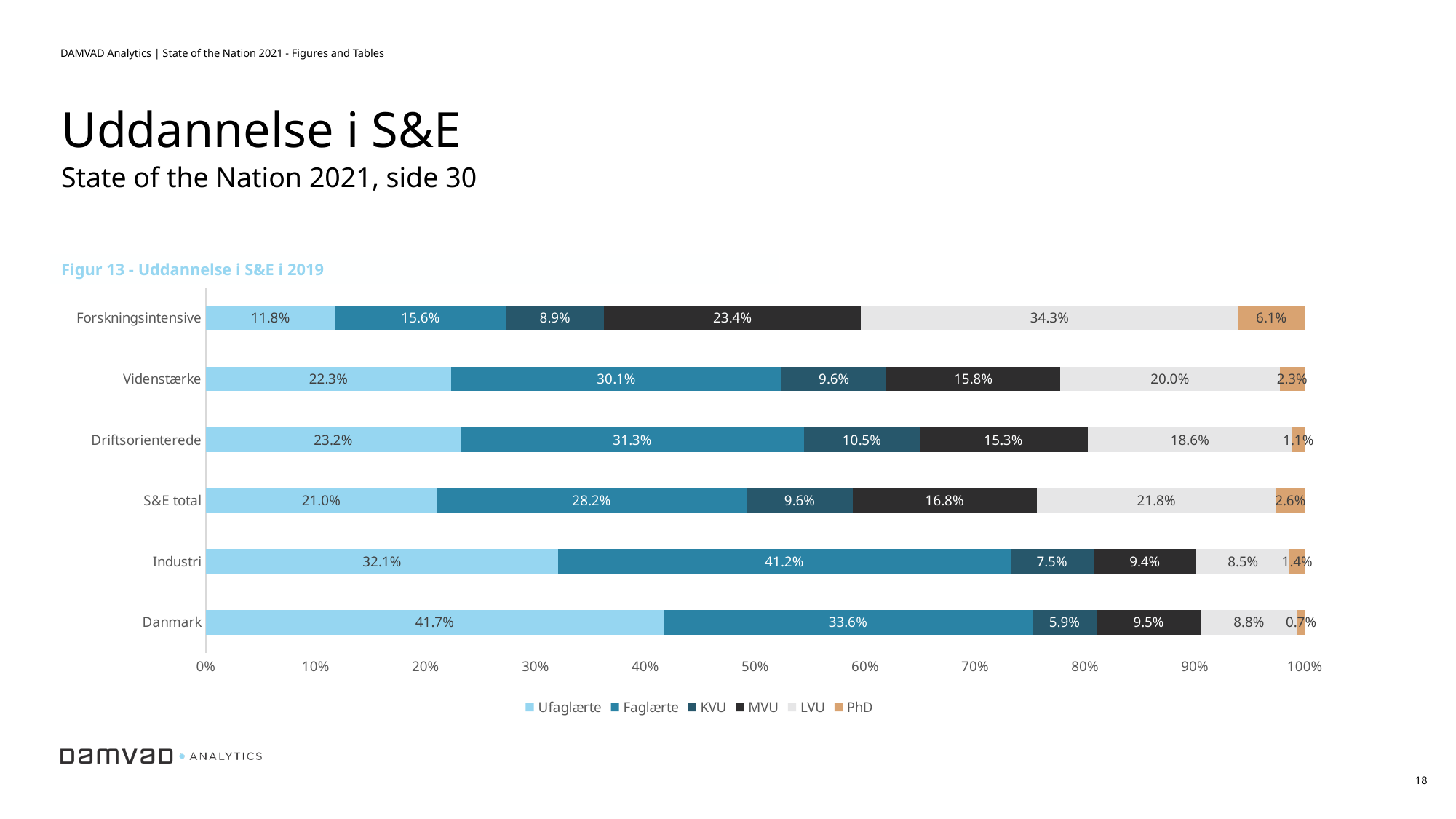
What is the PhD share for Videnstærke? 2.3% What is the KVU share for Driftsorienterede? 10.5% What is the LVU share for Forskningsintensive? 34.3% Which has a larger LVU share, Videnstærke or S&E total? S&E total Is the MVU share for Forskningsintensive greater or less than 20%? greater How many categories are shown on the y axis? 6 Which category has the lowest Ufaglærte share? Forskningsintensive Which category has the highest PhD share? Forskningsintensive What is the Ufaglærte share for Danmark? 41.7% How many series does the legend list? 6 What kind of chart is shown? Stacked bar chart What is the difference in Faglærte share between Industri and Danmark? 7.6 percentage points